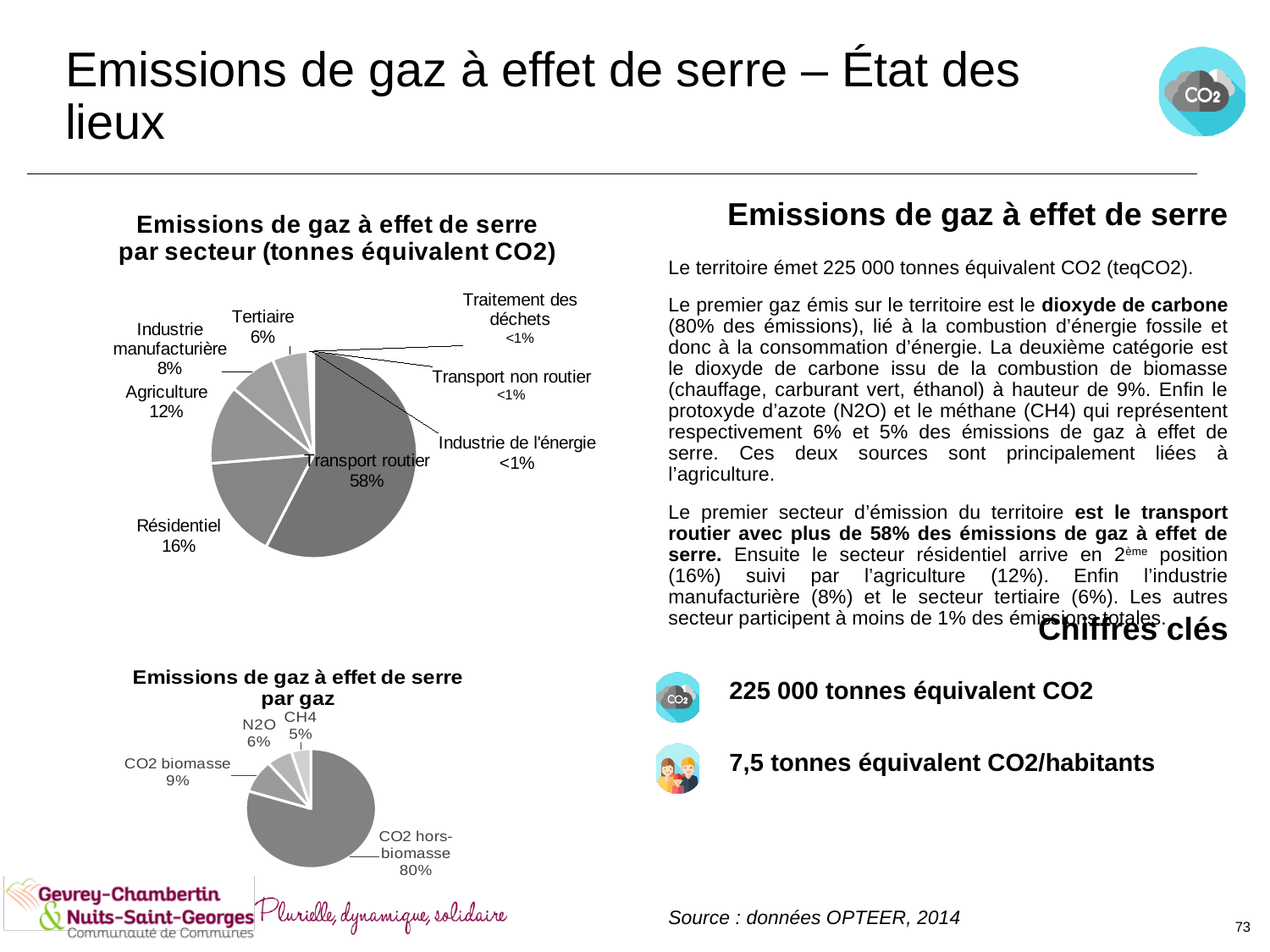
How many gases are shown in the chart 'Emissions de gaz à effet de serre par gaz'? 4 In the chart 'Emissions de gaz à effet de serre par secteur', which is larger: Industrie manufacturière or Agriculture? Agriculture In the chart 'Emissions de gaz à effet de serre par secteur', what is the value for Résidentiel? 16% In the chart 'Emissions de gaz à effet de serre par secteur', which sector has the largest share? Transport routier In the chart 'Emissions de gaz à effet de serre par secteur', what share of emissions comes from Transport routier? 58% How many sectors are shown in the chart 'Emissions de gaz à effet de serre par secteur'? 8 In the chart 'Emissions de gaz à effet de serre par gaz', which gas has the smallest share? CH4 In the chart 'Emissions de gaz à effet de serre par gaz', what is the difference between CO2 biomasse and N2O? 3 percentage points In the chart 'Emissions de gaz à effet de serre par secteur', what is the difference between the shares of Agriculture and Tertiaire? 6 percentage points What unit is given in the title of the top chart 'Emissions de gaz à effet de serre par secteur'? tonnes équivalent CO2 What kind of chart is 'Emissions de gaz à effet de serre par secteur'? Pie chart In the chart 'Emissions de gaz à effet de serre par gaz', what share is CO2 hors-biomasse? 80%